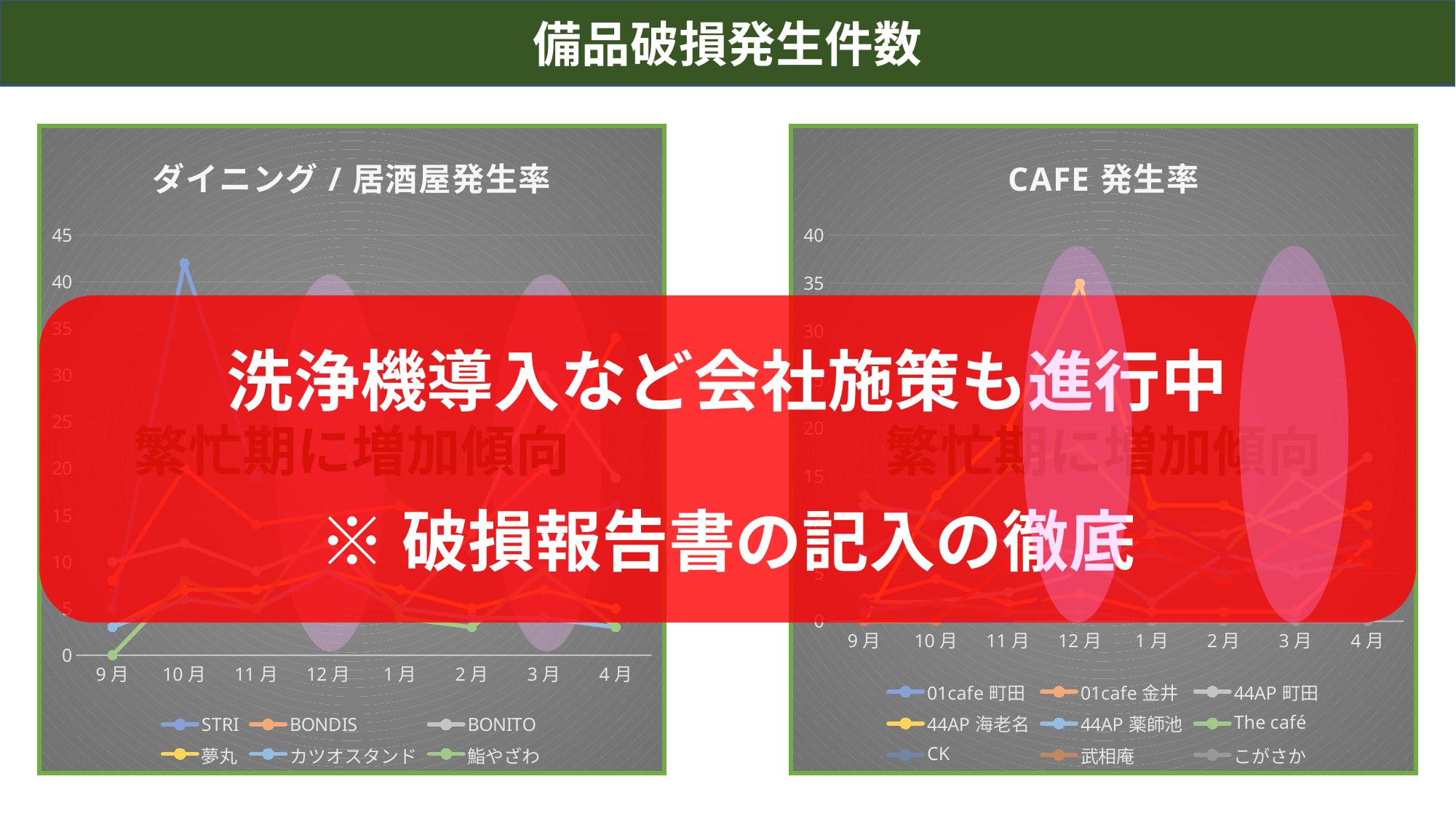
In the right chart (CAFE 発生率), how many months are shown on the x axis? 8 In the left chart (ダイニング / 居酒屋発生率), is the value for STRI in 9月 greater or less than 10? less What is the title of the chart on the right side of the slide? CAFE 発生率 What kind of chart is the left chart titled ダイニング / 居酒屋発生率? line chart What is the title of the chart on the left side of the slide? ダイニング / 居酒屋発生率 What kind of chart is the right chart titled CAFE 発生率? line chart In the left chart (ダイニング / 居酒屋発生率), is the value for 鮨やざわ in 9月 greater or less than 5? less In the right chart (CAFE 発生率), is the value for 44AP 海老名 in 12月 greater or less than 30? greater In the right chart (CAFE 発生率), how many series does the legend list? 9 In the left chart (ダイニング / 居酒屋発生率), how many months are shown on the x axis? 8 In the left chart (ダイニング / 居酒屋発生率), how many series does the legend list? 6